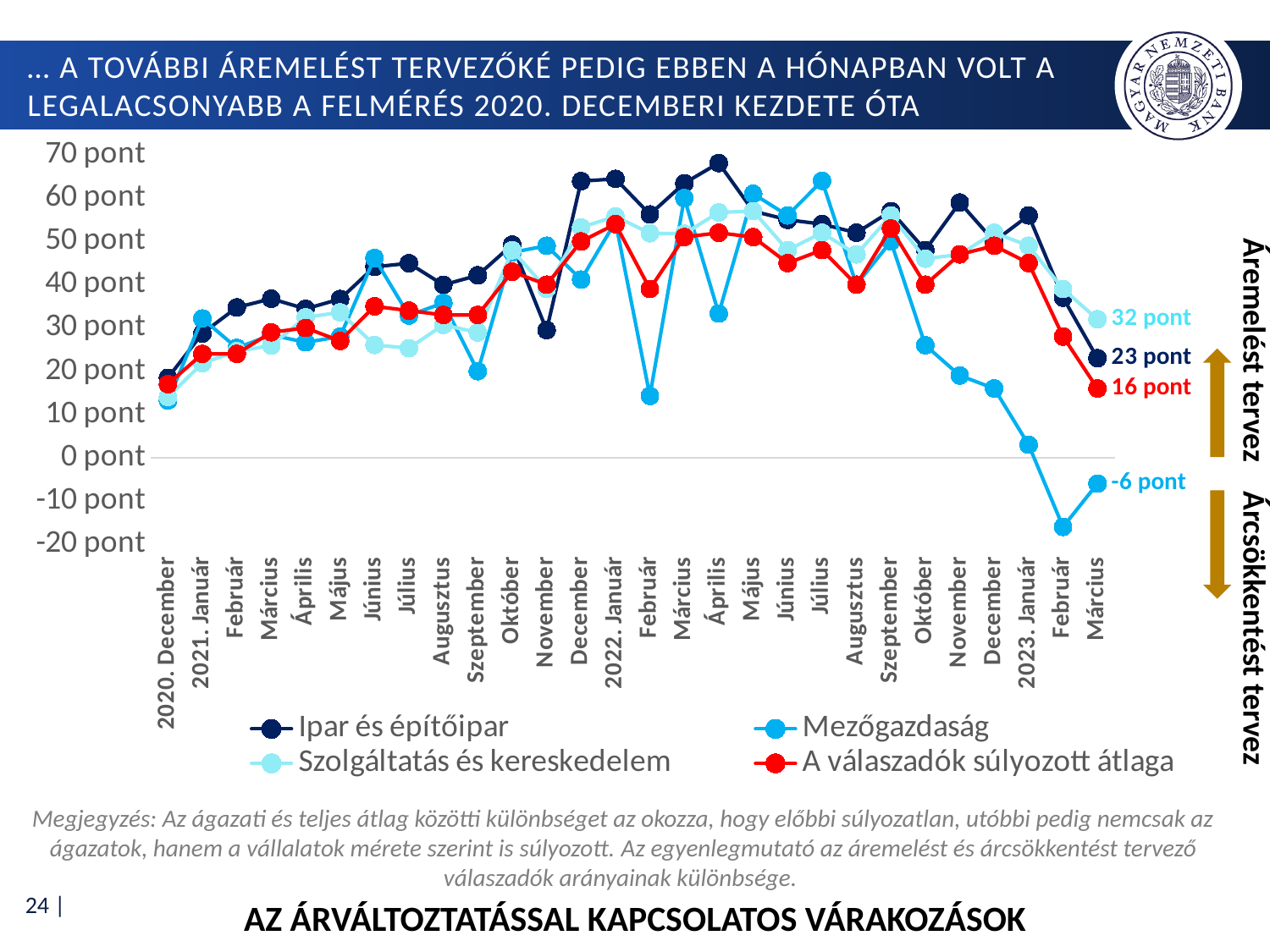
In 2023. Március, which is larger: Ipar és építőipar or A válaszadók súlyozott átlaga? Ipar és építőipar How many series does the legend list? 4 What is the value for Mezőgazdaság in 2023. Március? -6 pont What is the value for Szolgáltatás és kereskedelem in 2023. Március? 32 pont What is the value for A válaszadók súlyozott átlaga in 2023. Március? 16 pont Is the value for Ipar és építőipar in 2022. Április greater or less than 60 pont? greater Which series has the highest value in 2023. Március? Szolgáltatás és kereskedelem Is the value for Mezőgazdaság in 2023. Február greater or less than 0 pont? less What is the difference between Szolgáltatás és kereskedelem and Mezőgazdaság in 2023. Március? 38 pont What is the value for Ipar és építőipar in 2023. Március? 23 pont What kind of chart is shown on the slide? line chart Which series has the lowest value in 2023. Március? Mezőgazdaság